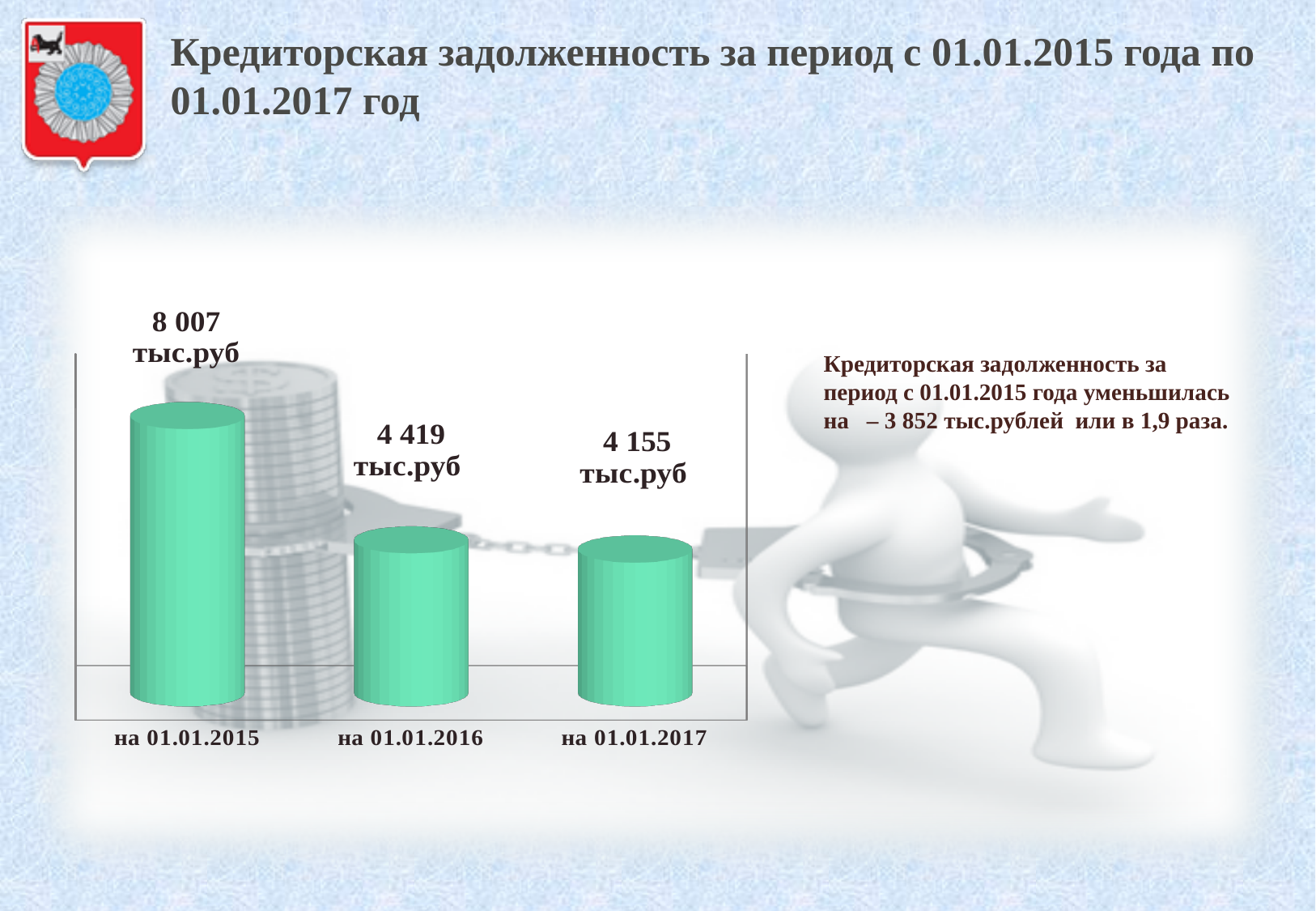
What is the value for на 01.01.2017? 4 155 тыс.руб Which date has the highest value? на 01.01.2015 What is the value for на 01.01.2016? 4 419 тыс.руб What kind of chart is shown on the slide? bar chart What is the difference between the values for на 01.01.2015 and на 01.01.2016? 3 588 тыс.руб Which is larger, the value for на 01.01.2015 or the value for на 01.01.2017? на 01.01.2015 Which date has the lowest value? на 01.01.2017 Do the values rise or fall from на 01.01.2015 to на 01.01.2017? fall How many dates are shown on the chart? 3 What is the difference between the values for на 01.01.2016 and на 01.01.2017? 264 тыс.руб What is the difference between the values for на 01.01.2015 and на 01.01.2017? 3 852 тыс.руб What is the value for на 01.01.2015? 8 007 тыс.руб